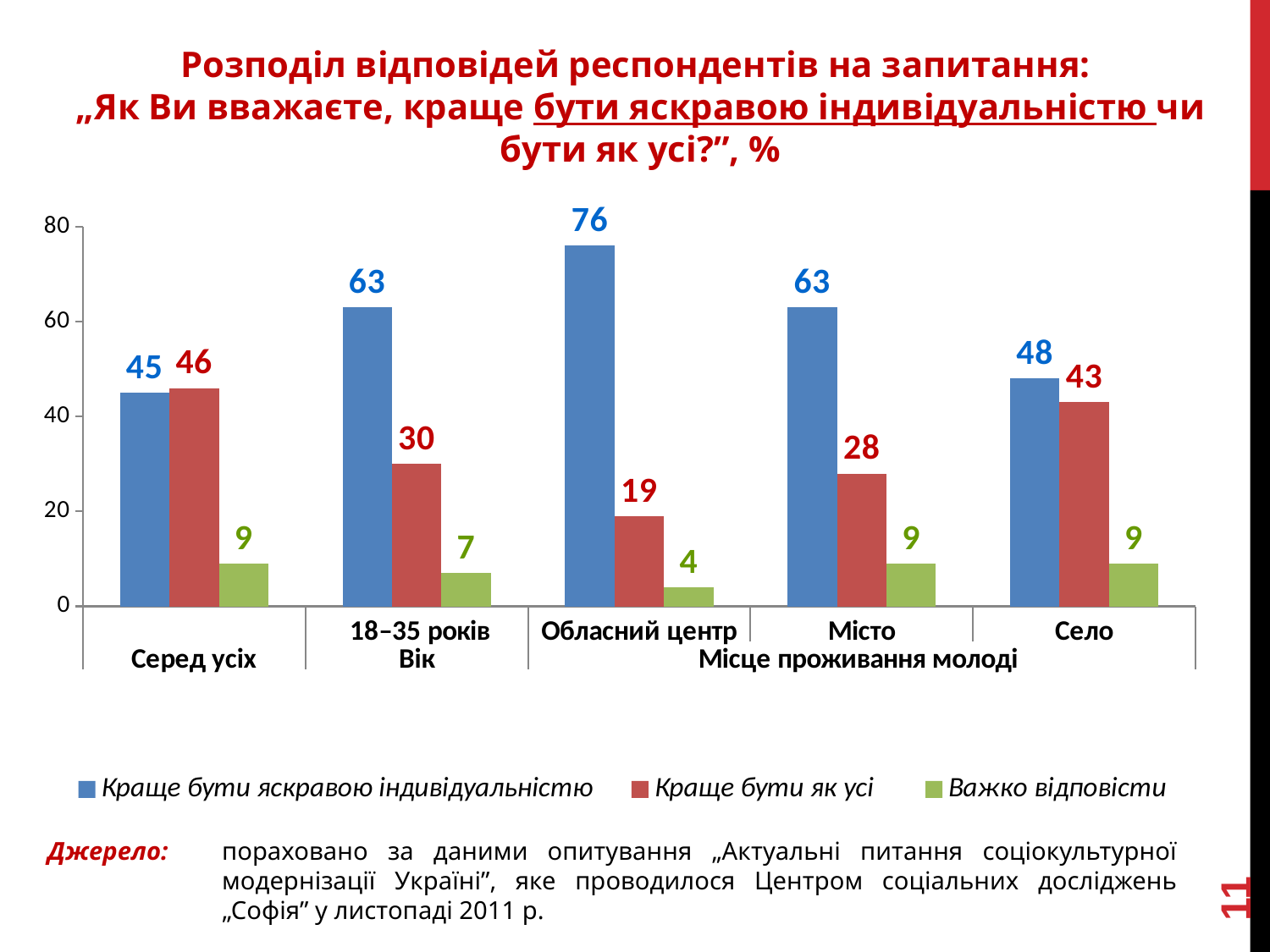
How many categories are shown on the x axis of the chart? 5 How many series does the legend list? 3 What is the difference between the "Краще бути яскравою індивідуальністю" and "Краще бути як усі" values in the "Місто" category? 35 Which colour represents the series "Важко відповісти" in the chart? Green In which category is the value for "Краще бути яскравою індивідуальністю" the highest? Обласний центр What is the value for "Краще бути як усі" in the "Село" category? 43 What is the value for "Важко відповісти" in the "18–35 років" category? 7 What kind of chart is shown on the slide? Bar chart What is the value for "Краще бути як усі" in the "Серед усіх" category? 46 What is the value for "Краще бути яскравою індивідуальністю" in the "Обласний центр" category? 76 Which is larger in the "Серед усіх" category: "Краще бути яскравою індивідуальністю" or "Краще бути як усі"? Краще бути як усі In which category is the value for "Важко відповісти" the lowest? Обласний центр